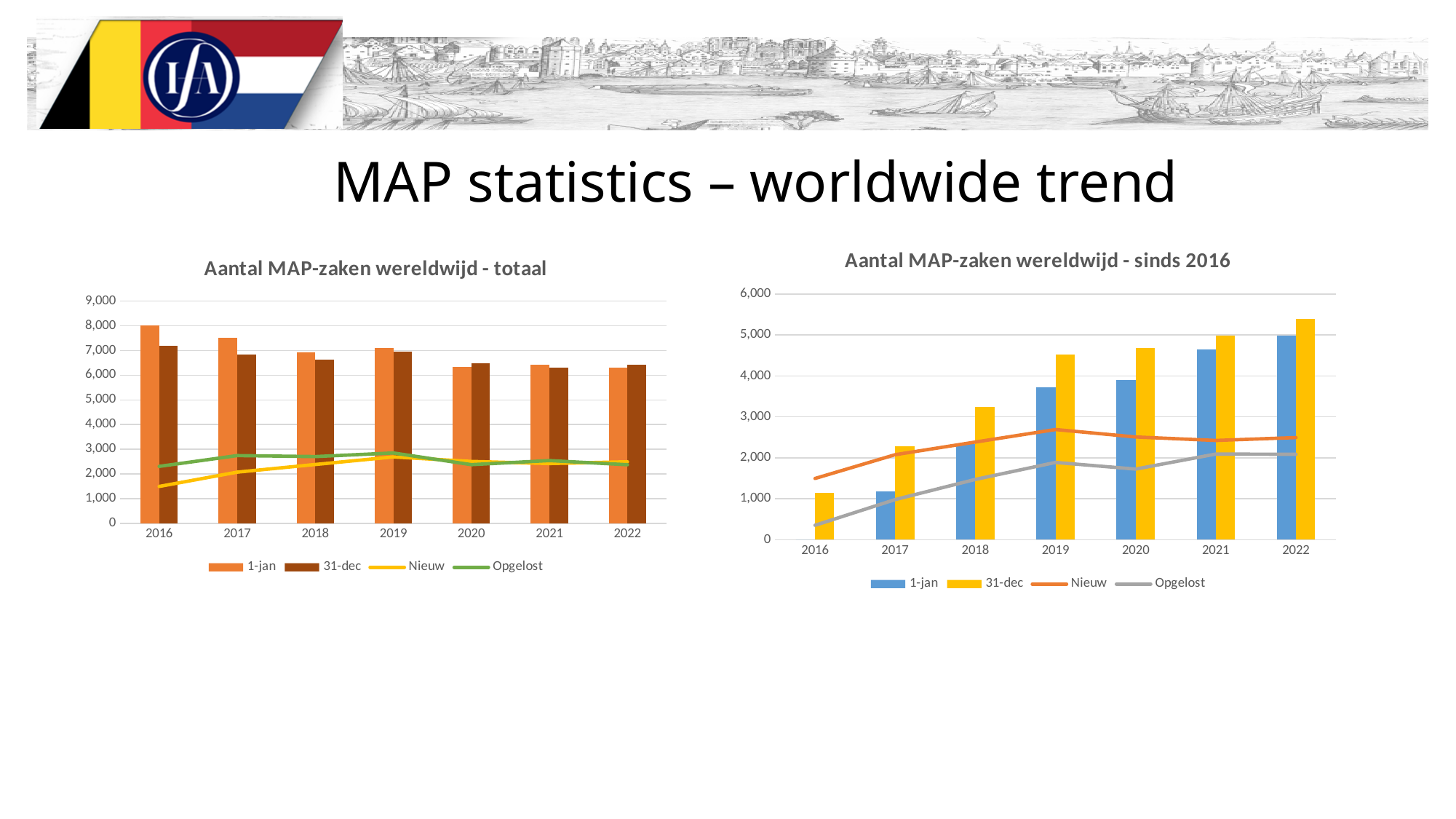
In the chart 'Aantal MAP-zaken wereldwijd - totaal', is the 1-jan value for 2016 greater or less than 7,000? greater In the chart 'Aantal MAP-zaken wereldwijd - sinds 2016', is the 31-dec value for 2022 greater or less than 5,000? greater In the chart 'Aantal MAP-zaken wereldwijd - sinds 2016', do the 31-dec bars rise or fall from 2016 to 2022? rise In the chart 'Aantal MAP-zaken wereldwijd - totaal', how many series does the legend list? 4 In the chart 'Aantal MAP-zaken wereldwijd - totaal', how many years are shown on the x axis? 7 In the chart 'Aantal MAP-zaken wereldwijd - sinds 2016', which is larger: the 1-jan value for 2017 or for 2022? 2022 In the chart 'Aantal MAP-zaken wereldwijd - sinds 2016', which year has the lowest 31-dec value? 2016 In the chart 'Aantal MAP-zaken wereldwijd - totaal', do the 1-jan bars generally rise or fall from 2016 to 2022? fall What kind of chart is 'Aantal MAP-zaken wereldwijd - totaal'? Combined bar and line chart In the chart 'Aantal MAP-zaken wereldwijd - totaal', which year has the highest 1-jan value? 2016 In the chart 'Aantal MAP-zaken wereldwijd - sinds 2016', what colour is the Opgelost line? grey In the chart 'Aantal MAP-zaken wereldwijd - sinds 2016', which year has the highest 31-dec value? 2022